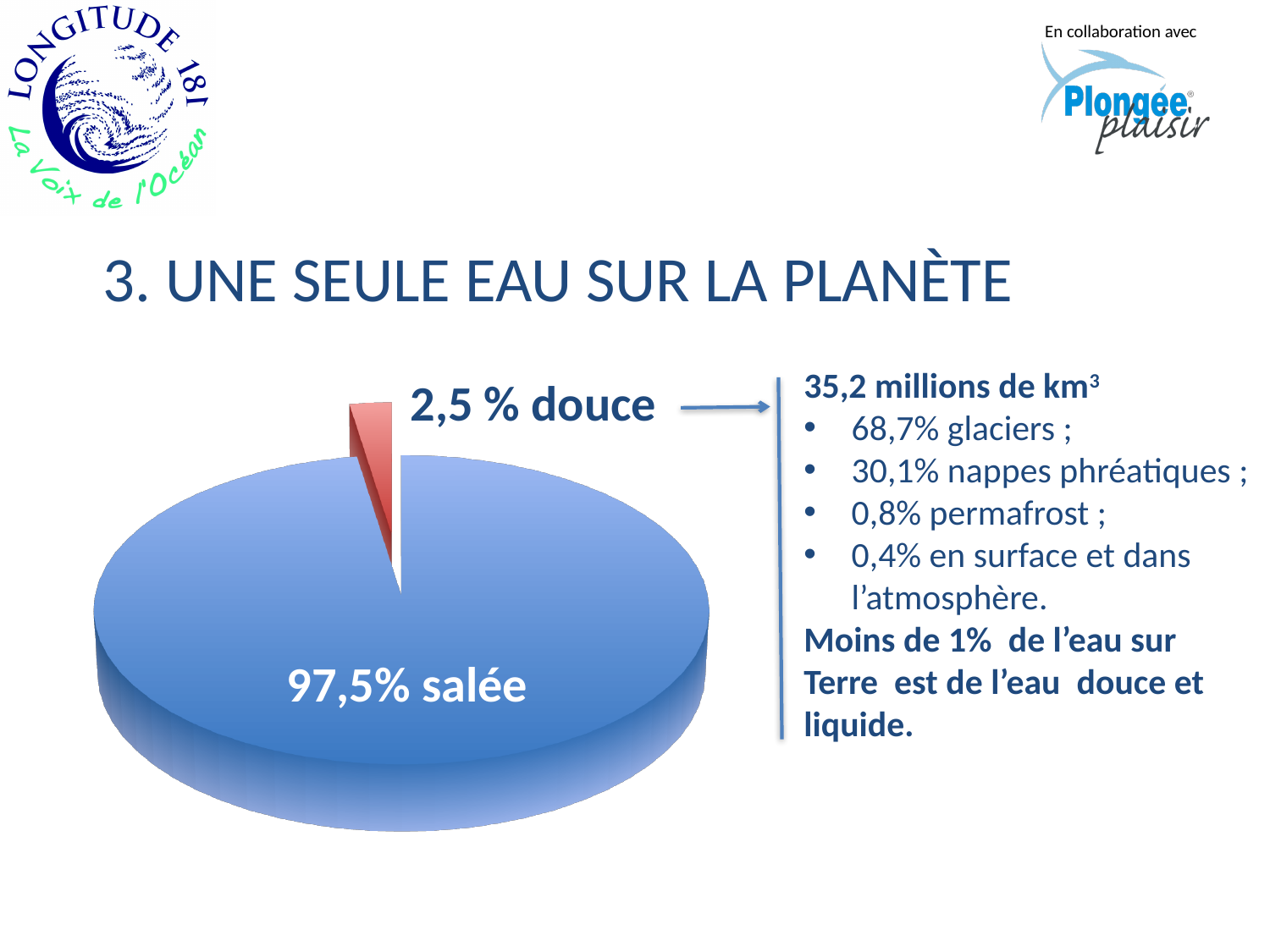
What is the difference in percentage points between the "salée" slice and the "douce" slice? 95 What colour is the "salée" slice in the pie chart? blue What percentage of the pie chart is labelled "salée"? 97,5% What colour is the "douce" slice in the pie chart? red How many slices does the pie chart have? 2 Which is larger in the pie chart, the "salée" slice or the "douce" slice? salée What percentage of the pie chart is labelled "douce"? 2,5 % What kind of chart is shown on the slide? pie chart What share of the pie does the "douce" slice represent? 2,5 % Which slice of the pie chart is the smallest? douce Which slice of the pie chart is the largest? salée